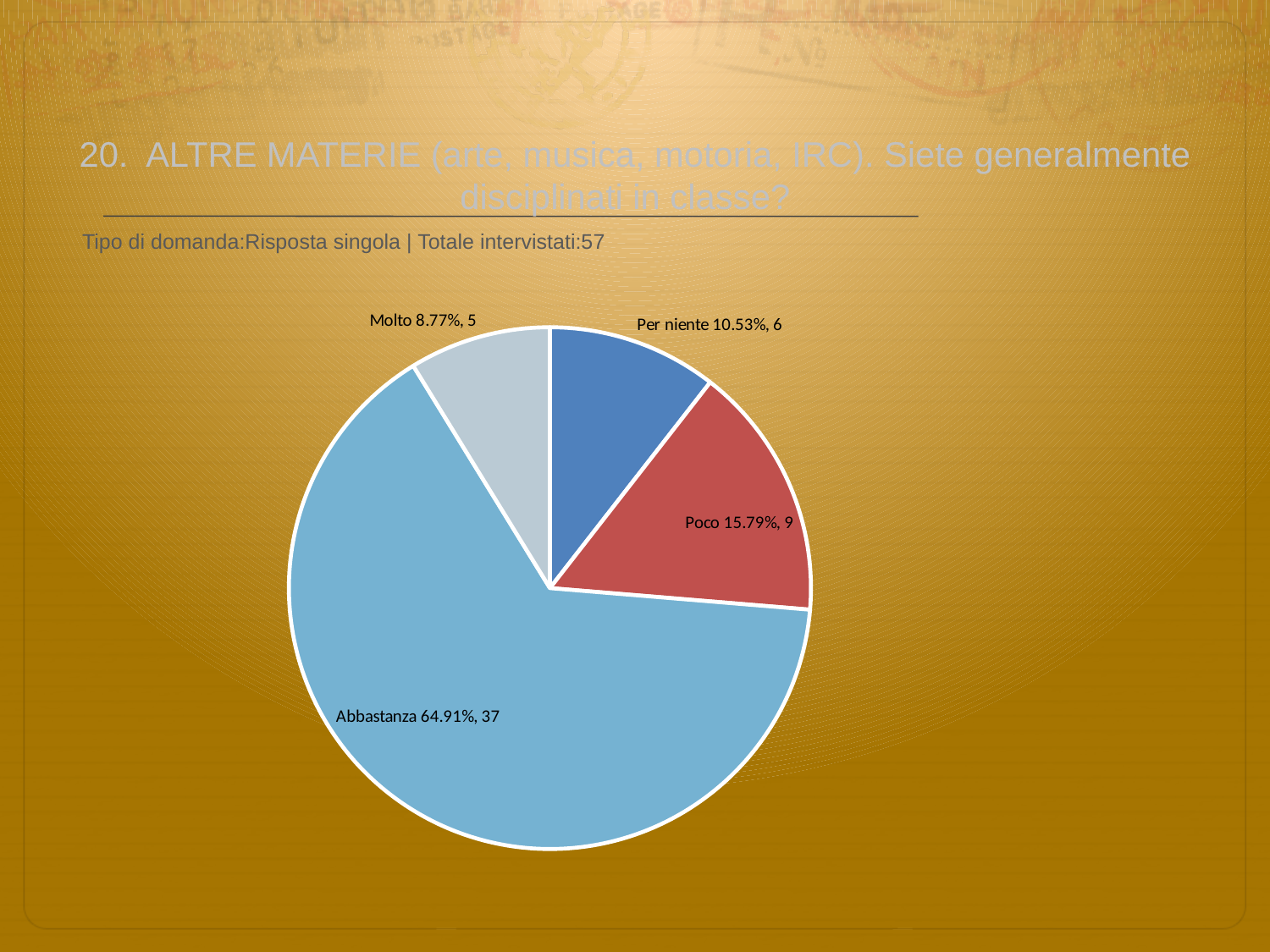
What kind of chart is shown on the slide? pie chart What percentage is shown for the Abbastanza slice? 64.91% What colour is the Poco slice? red Which has more respondents, Per niente or Molto? Per niente How many respondents answered Poco? 9 How many slices does the pie chart have? 4 Which category has the smallest share of the pie? Molto What percentage is shown for the Per niente slice? 10.53% Which category has the largest share of the pie? Abbastanza What is the difference in respondent count between Abbastanza and Poco? 28 How many respondents answered Molto? 5 What is the total number of respondents across all slices? 57